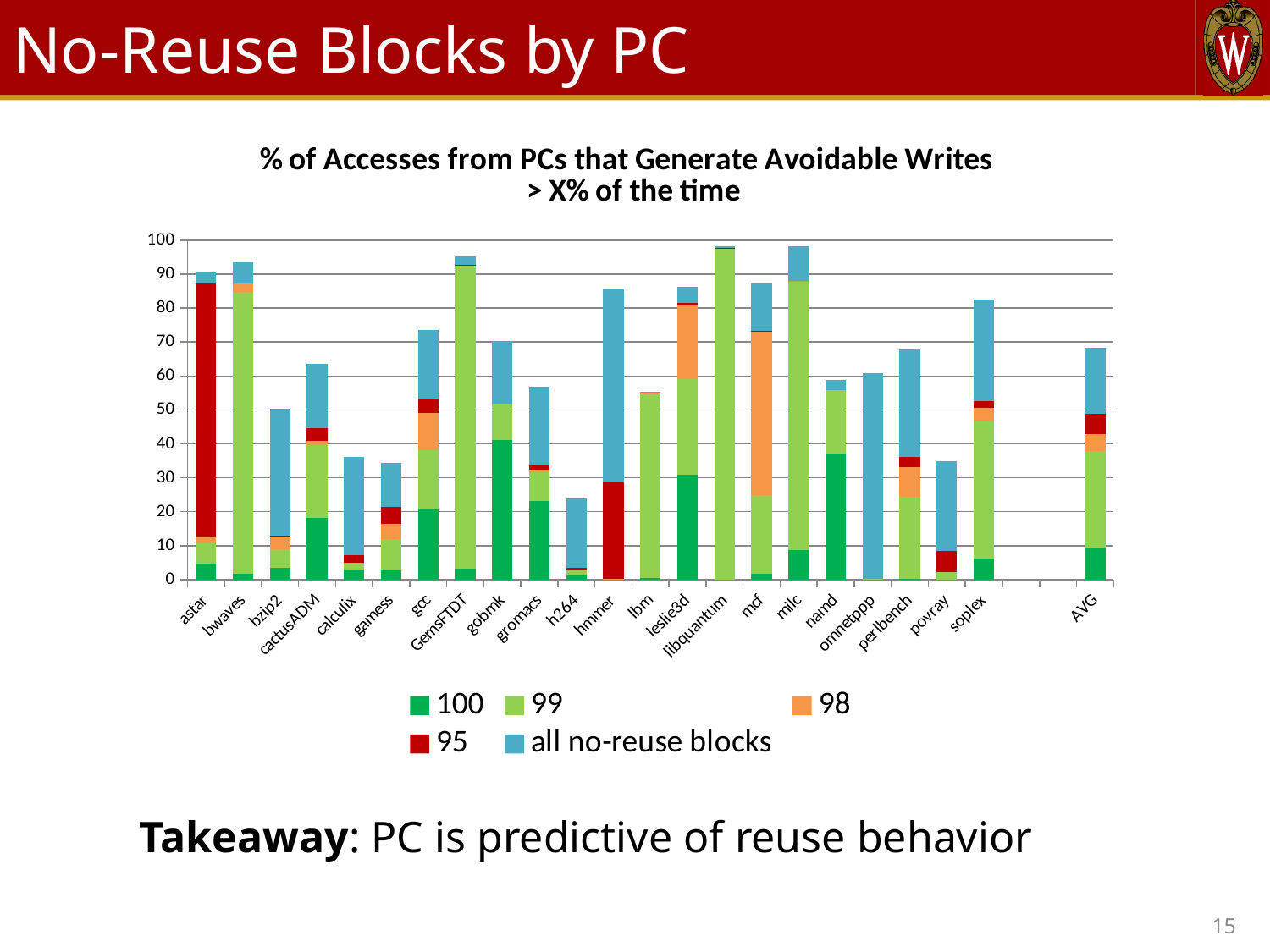
Which category has the lowest total bar height in the chart? h264 Is the total bar height for calculix greater or less than 40? less What kind of chart is shown on the slide? stacked bar chart Is the total bar height for h264 greater or less than 30? less Is the total bar height for AVG greater or less than 60? greater How many categories are shown along the x axis of the chart? 23 Which legend entry is shown in blue? all no-reuse blocks Which has the taller total bar, bwaves or bzip2? bwaves How many series does the chart's legend list? 5 What is the title of the chart? % of Accesses from PCs that Generate Avoidable Writes > X% of the time Which has the taller total bar, hmmer or lbm? hmmer